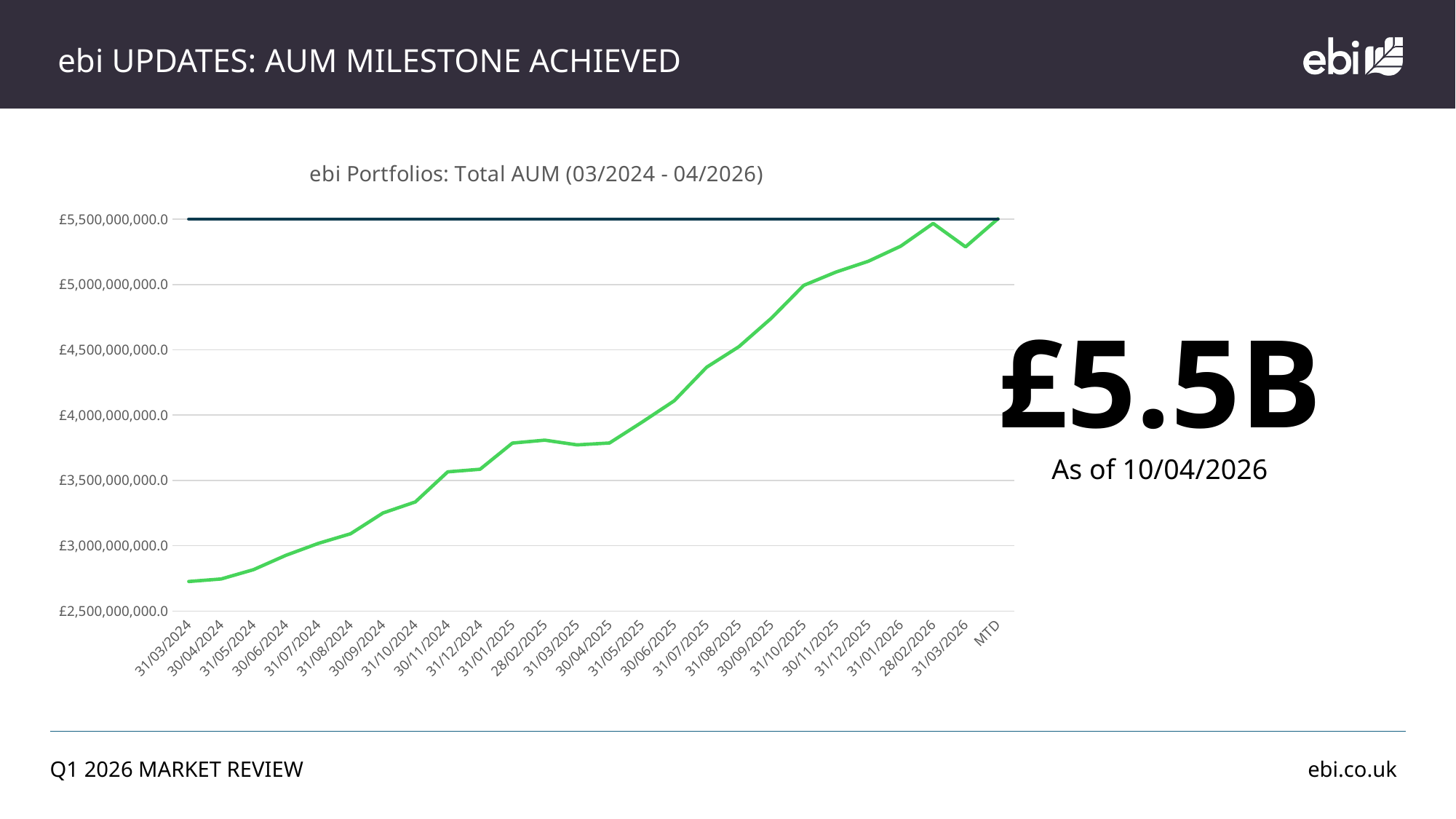
Is the total AUM for 31/07/2025 greater or less than £4,000,000,000.0? greater Which date has the lowest total AUM on the chart? 31/03/2024 Is the total AUM for 31/01/2025 greater or less than £3,500,000,000.0? greater Which has the higher total AUM, 28/02/2026 or 31/03/2026? 28/02/2026 Is the total AUM for 31/10/2025 greater or less than £4,500,000,000.0? greater What AUM milestone figure is displayed in large text next to the chart? £5.5B Does the total AUM generally rise or fall from 31/03/2024 to MTD? rise What is the title of the chart? ebi Portfolios: Total AUM (03/2024 - 04/2026) What kind of chart is shown on the slide? line chart How many dates (points) are shown along the x axis of the chart? 26